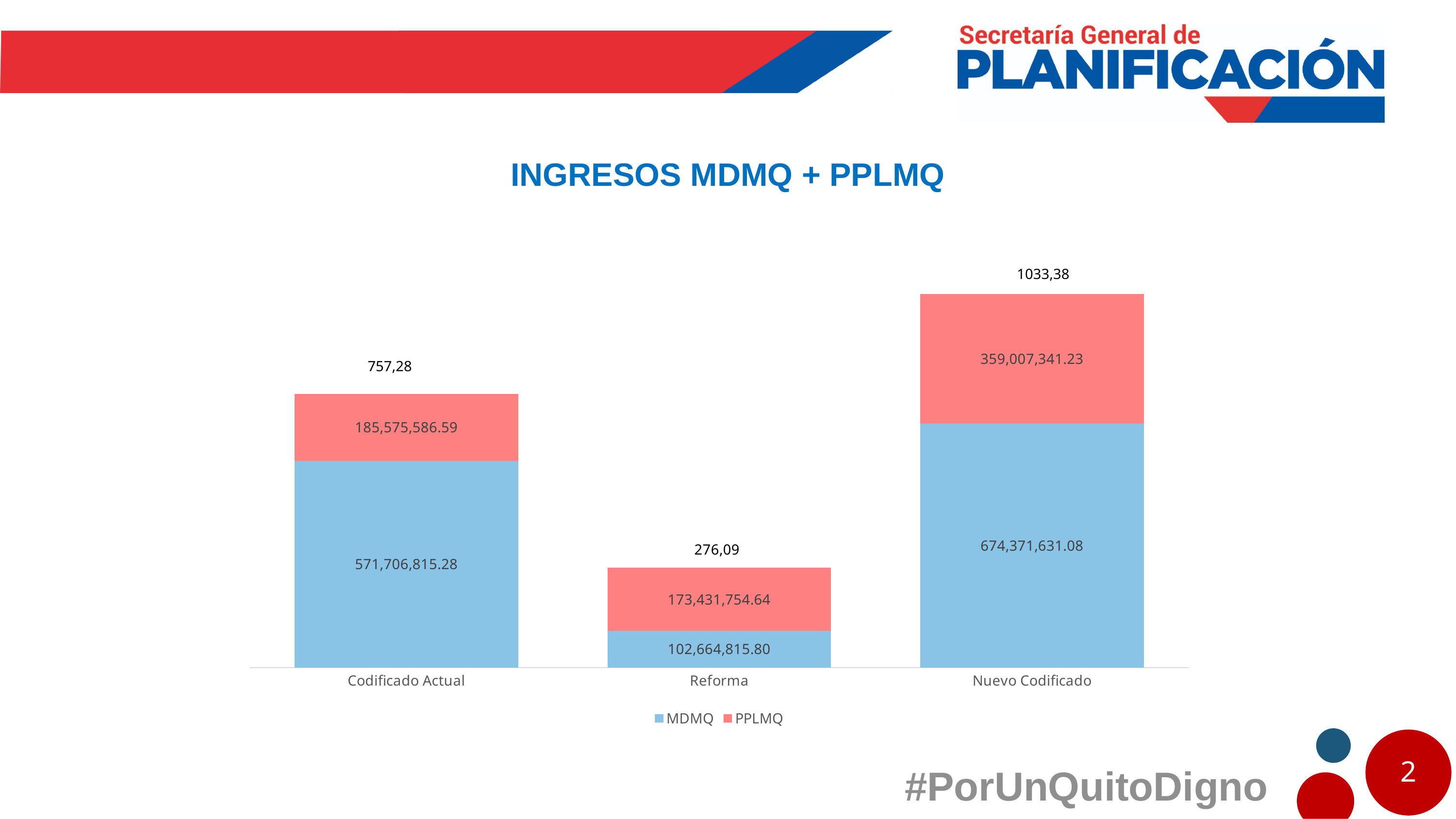
What is the PPLMQ value for Reforma? 173,431,754.64 Which category has the highest total bar? Nuevo Codificado What total is printed above the Nuevo Codificado bar? 1033,38 In the Reforma bar, which is larger, MDMQ or PPLMQ? PPLMQ What total is printed above the Reforma bar? 276,09 What is the PPLMQ value for Nuevo Codificado? 359,007,341.23 What is the difference between the MDMQ value for Nuevo Codificado and the MDMQ value for Codificado Actual? 102,664,815.80 Which category has the lowest total bar? Reforma How many categories are shown on the x axis? 3 How many series does the legend list? 2 What is the MDMQ value for Nuevo Codificado? 674,371,631.08 What is the MDMQ value for Codificado Actual? 571,706,815.28